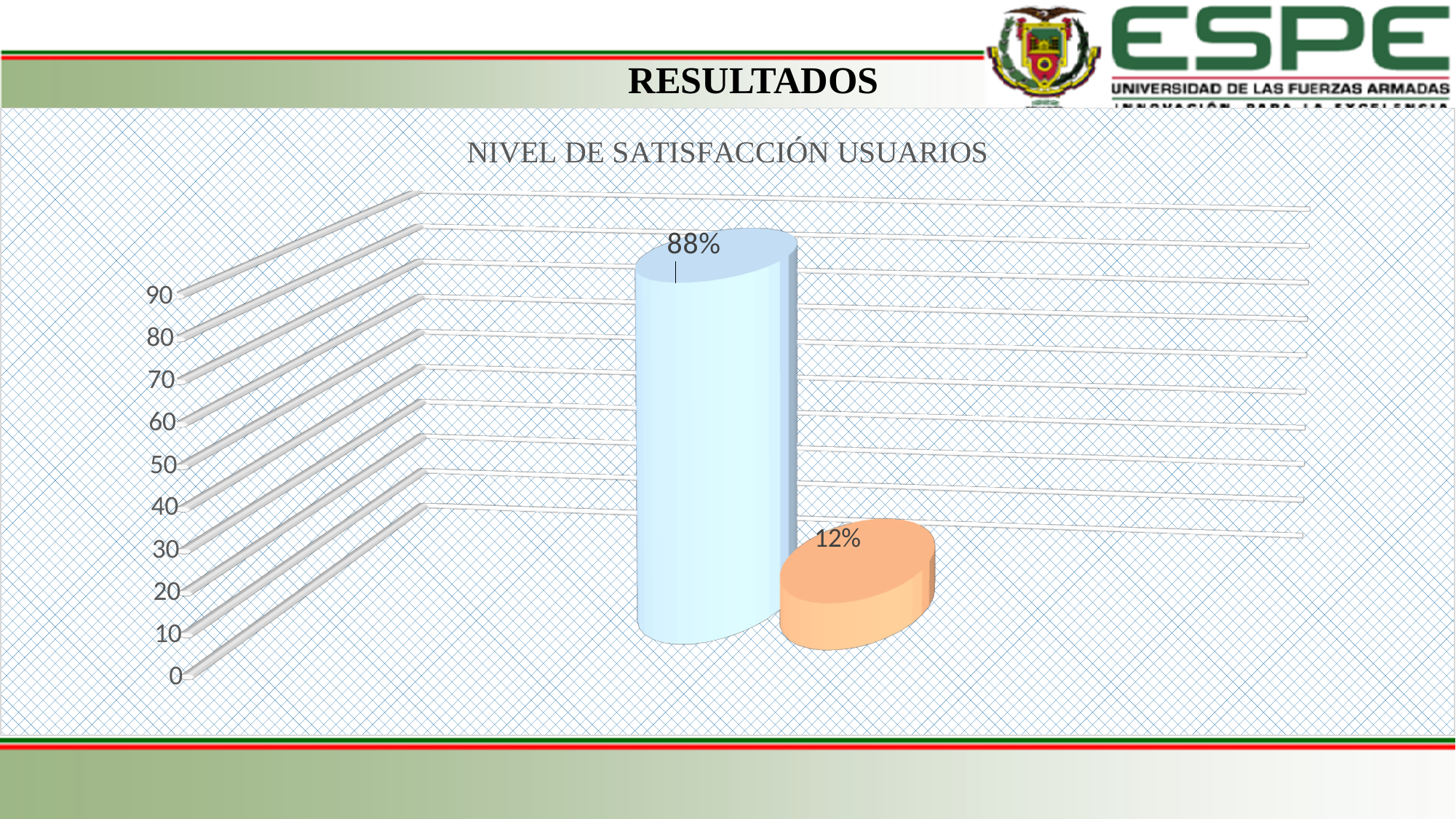
What kind of chart is shown on the slide? bar chart What is the value shown on the orange bar? 12% What is the highest tick value shown on the vertical axis? 90 What is the value shown on the light blue bar? 88% Which bar is taller, the light blue bar or the orange bar? the light blue bar What is the title of the chart? NIVEL DE SATISFACCIÓN USUARIOS What is the lowest value shown in the chart? 12% What is the difference between the two values shown in the chart? 76% Is the value of the light blue bar greater or less than 80? greater Is the value of the orange bar greater or less than 20? less How many bars are plotted in the chart? 2 What is the highest value shown in the chart? 88%